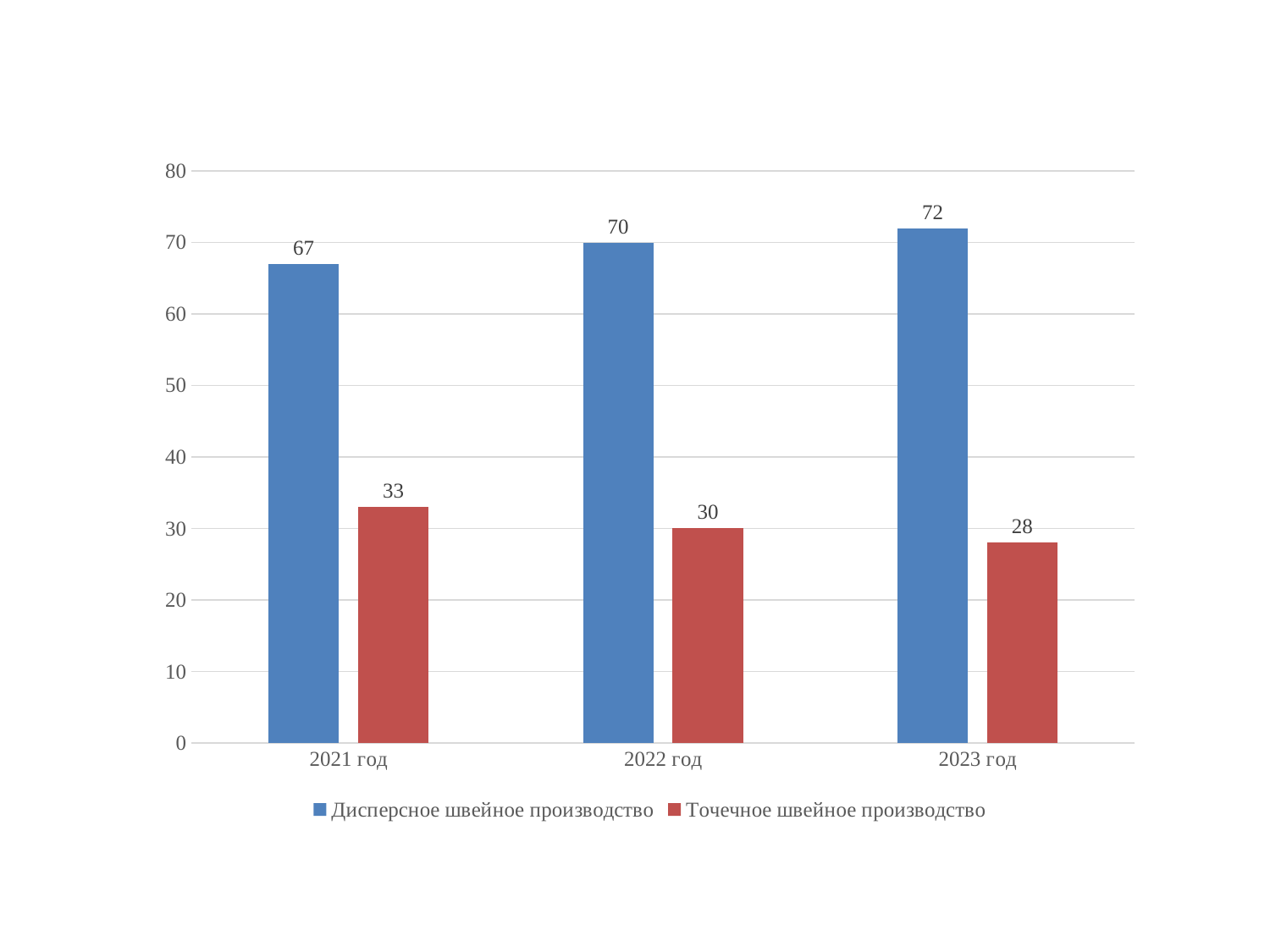
What is the difference between Дисперсное швейное производство and Точечное швейное производство in 2022 год? 40 What is the value for Точечное швейное производство in 2023 год? 28 In which year is Точечное швейное производство lowest? 2023 год What is the value for Точечное швейное производство in 2022 год? 30 Which is larger in 2021 год: Дисперсное швейное производство or Точечное швейное производство? Дисперсное швейное производство How many series does the legend list? 2 How many years are shown on the x axis? 3 What is the value for Дисперсное швейное производство in 2021 год? 67 In which year is Дисперсное швейное производство highest? 2023 год What kind of chart is shown on the slide? bar chart Does Точечное швейное производство rise or fall from 2021 год to 2023 год? fall Is the value for Точечное швейное производство in 2021 год greater or less than 40? less